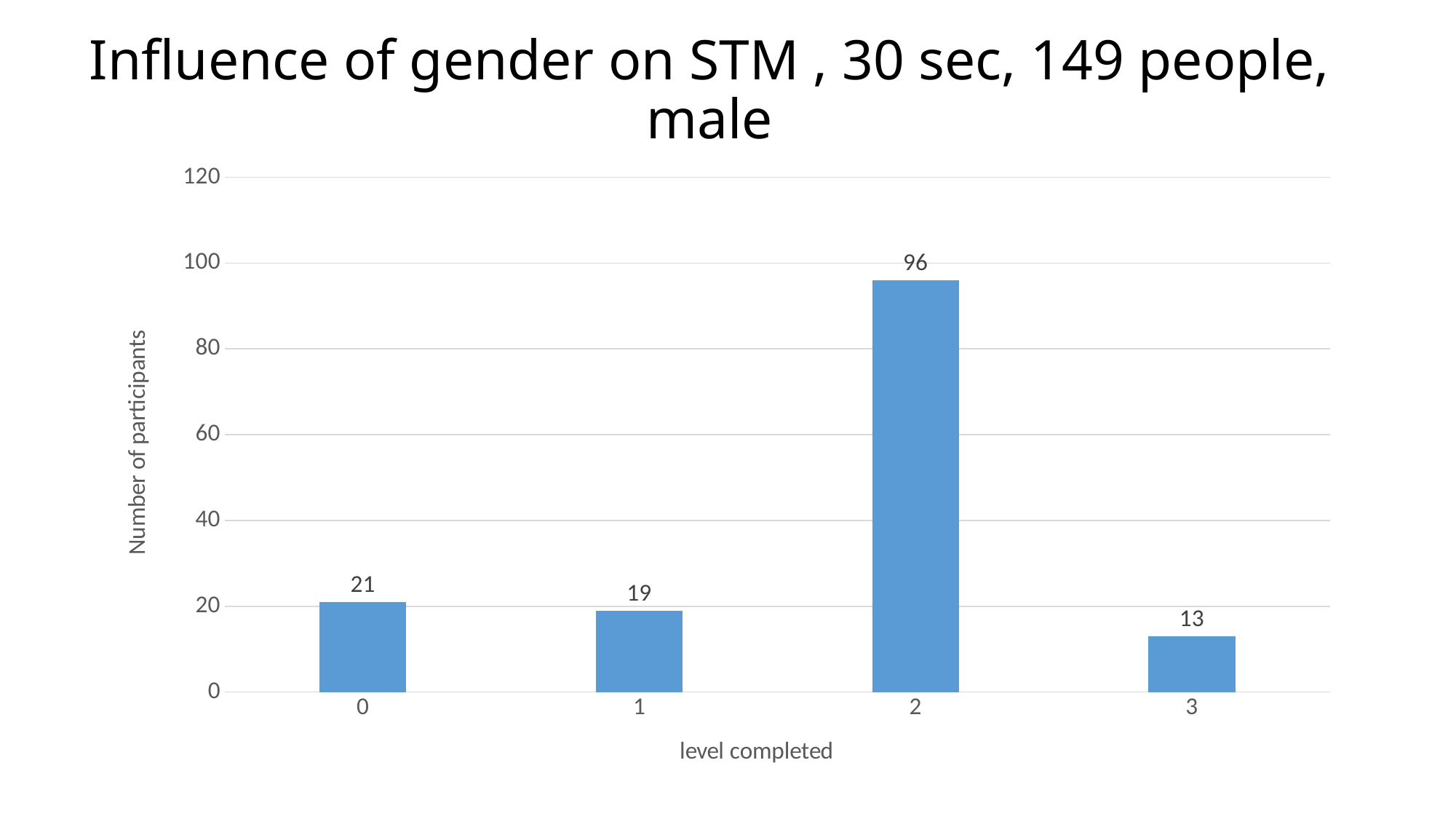
How many participants completed level 2? 96 What kind of chart is shown on the slide? bar chart Is the number of participants for level 2 greater or less than 80? greater What is the number of participants for level 3? 13 Which level completed has the highest number of participants? 2 What is the difference in number of participants between level 2 and level 1? 77 What is the difference in number of participants between level 0 and level 3? 8 How many level categories are shown on the x axis? 4 What is the label of the y axis? Number of participants Which level completed has the lowest number of participants? 3 Which has more participants, level 0 or level 1? level 0 What is the number of participants for level 0? 21